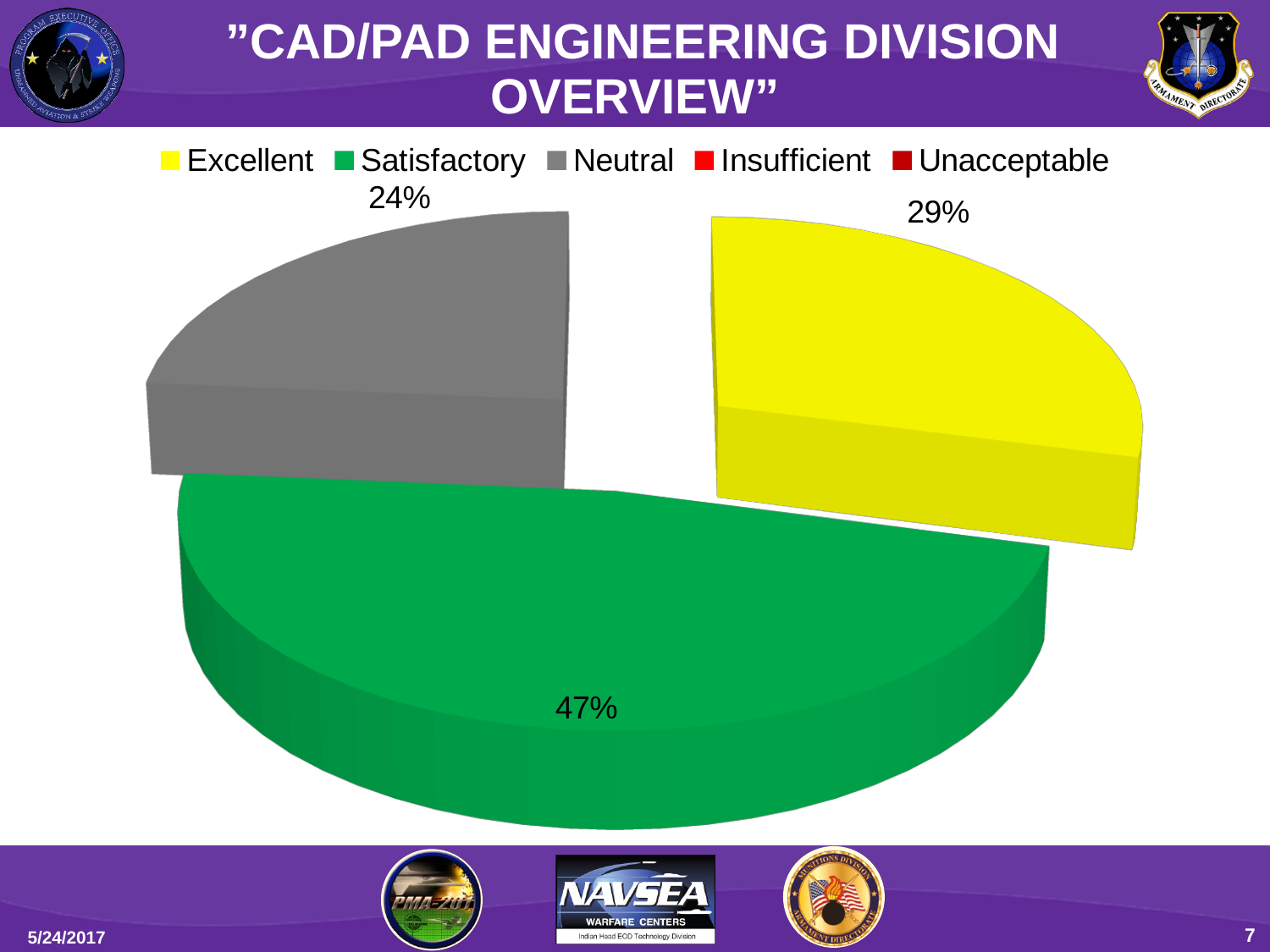
Which category has the largest slice of the pie? Satisfactory What colour is the Satisfactory slice? green How many categories does the legend list? 5 How many slices are visible in the pie? 3 What share of the pie does the Excellent slice represent? 29% What kind of chart is shown on the slide? pie chart Which slice is larger, Excellent or Neutral? Excellent What share of the pie does the Satisfactory slice represent? 47% What is the difference in percentage points between the Excellent and Neutral slices? 5 What share of the pie does the Neutral slice represent? 24% Which of the visible slices is the smallest? Neutral What is the difference in percentage points between the Satisfactory and Excellent slices? 18